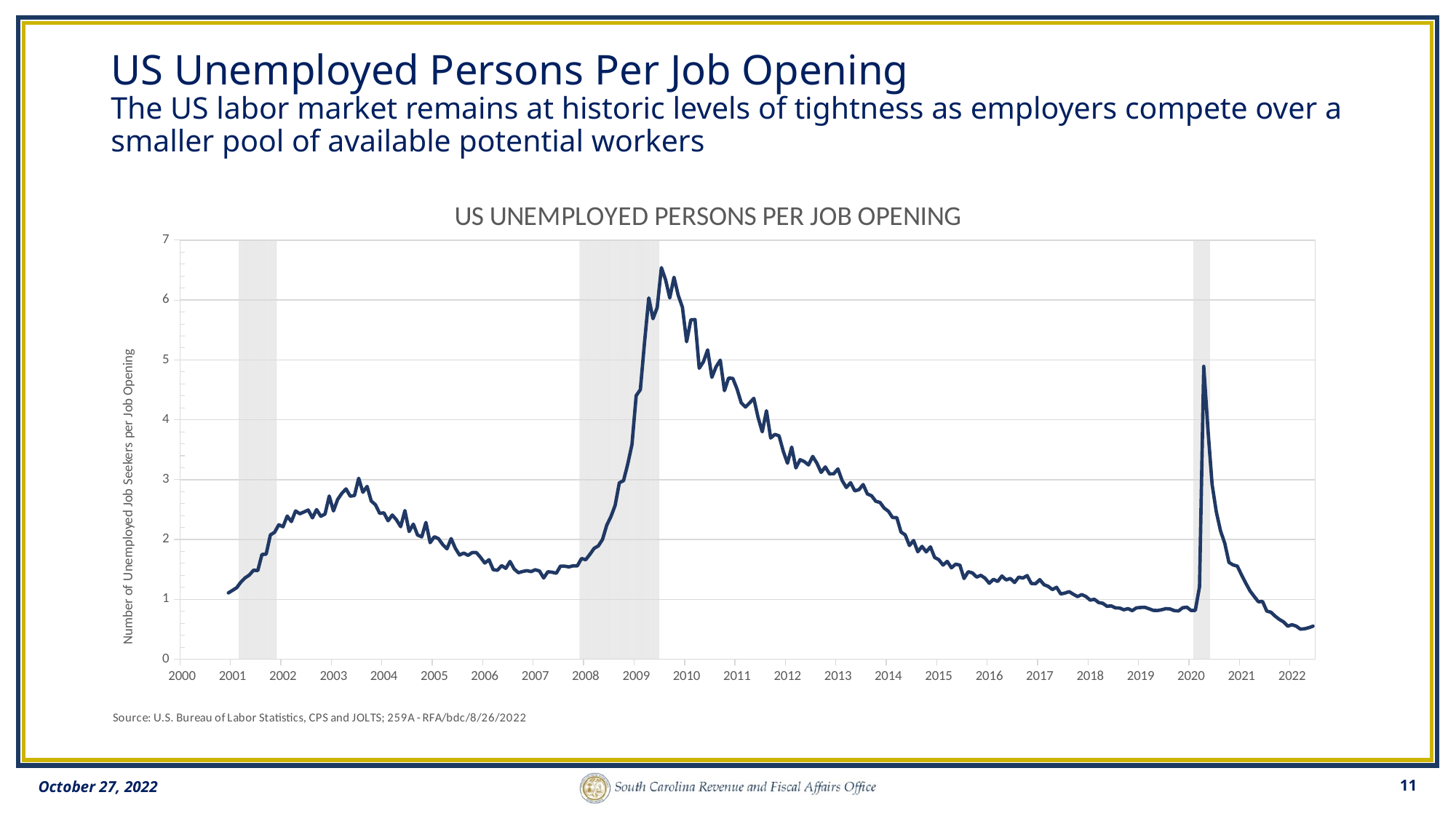
Is the peak value around 2003 greater or less than 2? greater Is the value in mid-2022 greater or less than 1? less Is the peak value around 2009 greater or less than 6? greater What is the title of the chart? US UNEMPLOYED PERSONS PER JOB OPENING In which year does the line reach its highest value? 2009 What kind of chart is shown on the slide? Line chart In which year does the line reach its lowest value? 2022 Which peak is higher: the one around 2009 or the one around 2020? 2009 What is the label on the vertical axis of the chart? Number of Unemployed Job Seekers per Job Opening Does the line generally rise or fall between 2010 and 2019? fall Does the line rise or fall between 2001 and 2003? rise